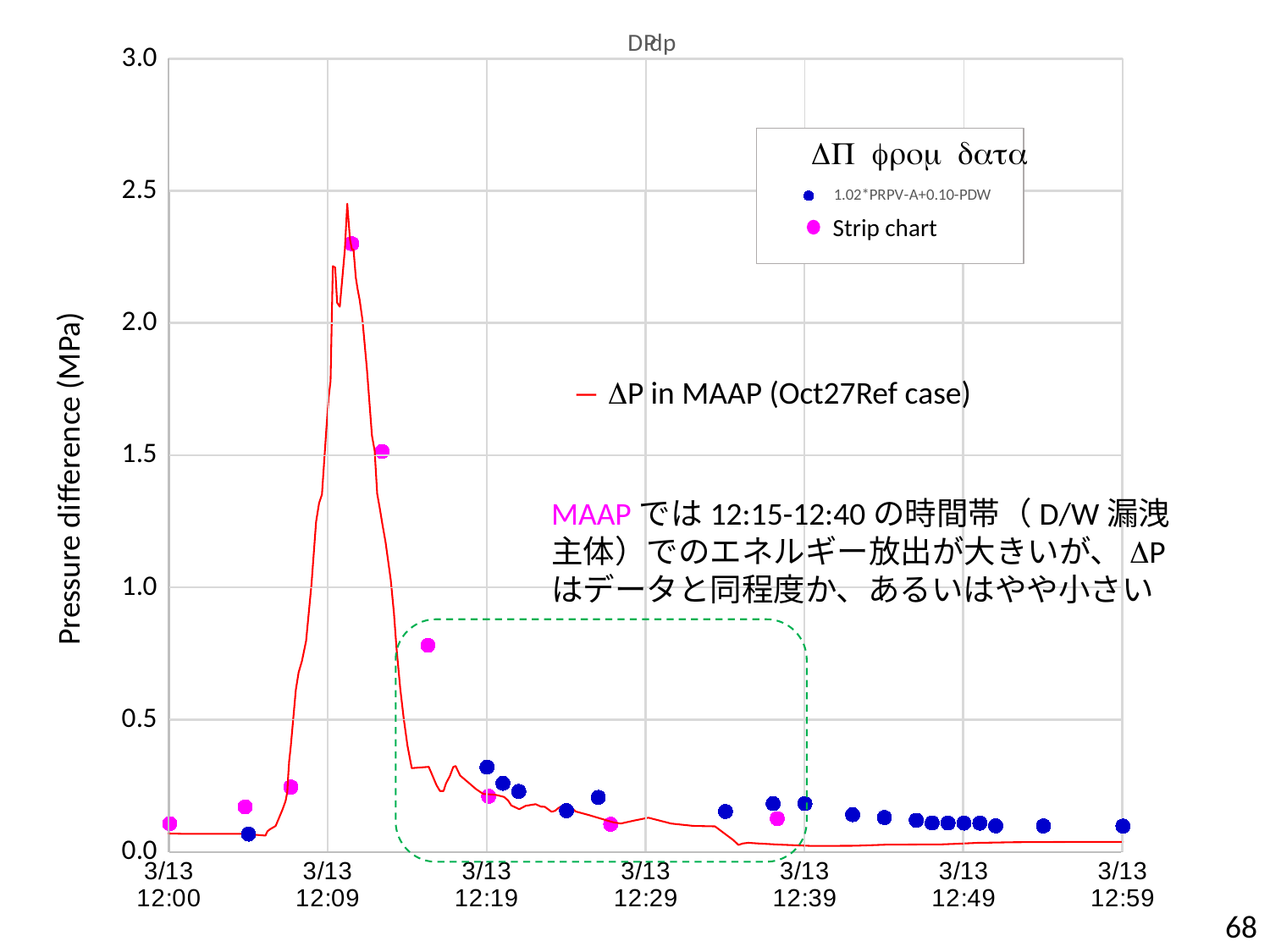
Is the 1.02*PRPV-A+0.10-PDW point at 3/13 12:59 greater or less than 0.5? less What colour is the ΔP in MAAP (Oct27Ref case) line? red Is the highest Strip chart point greater or less than 2.0? greater Is the peak value of the red ΔP in MAAP line greater or less than 2.0? greater How many entries does the legend box in the upper right list? 2 Does the red ΔP in MAAP line rise or fall between 3/13 12:00 and 3/13 12:09? rise What kind of chart is shown on the slide? line chart with scatter points Does the red ΔP in MAAP line rise or fall between 3/13 12:19 and 3/13 12:59? fall Which is larger: the Strip chart point just after 3/13 12:13 or the 1.02*PRPV-A+0.10-PDW point at 3/13 12:19? the Strip chart point What is the label of the y axis? Pressure difference (MPa)